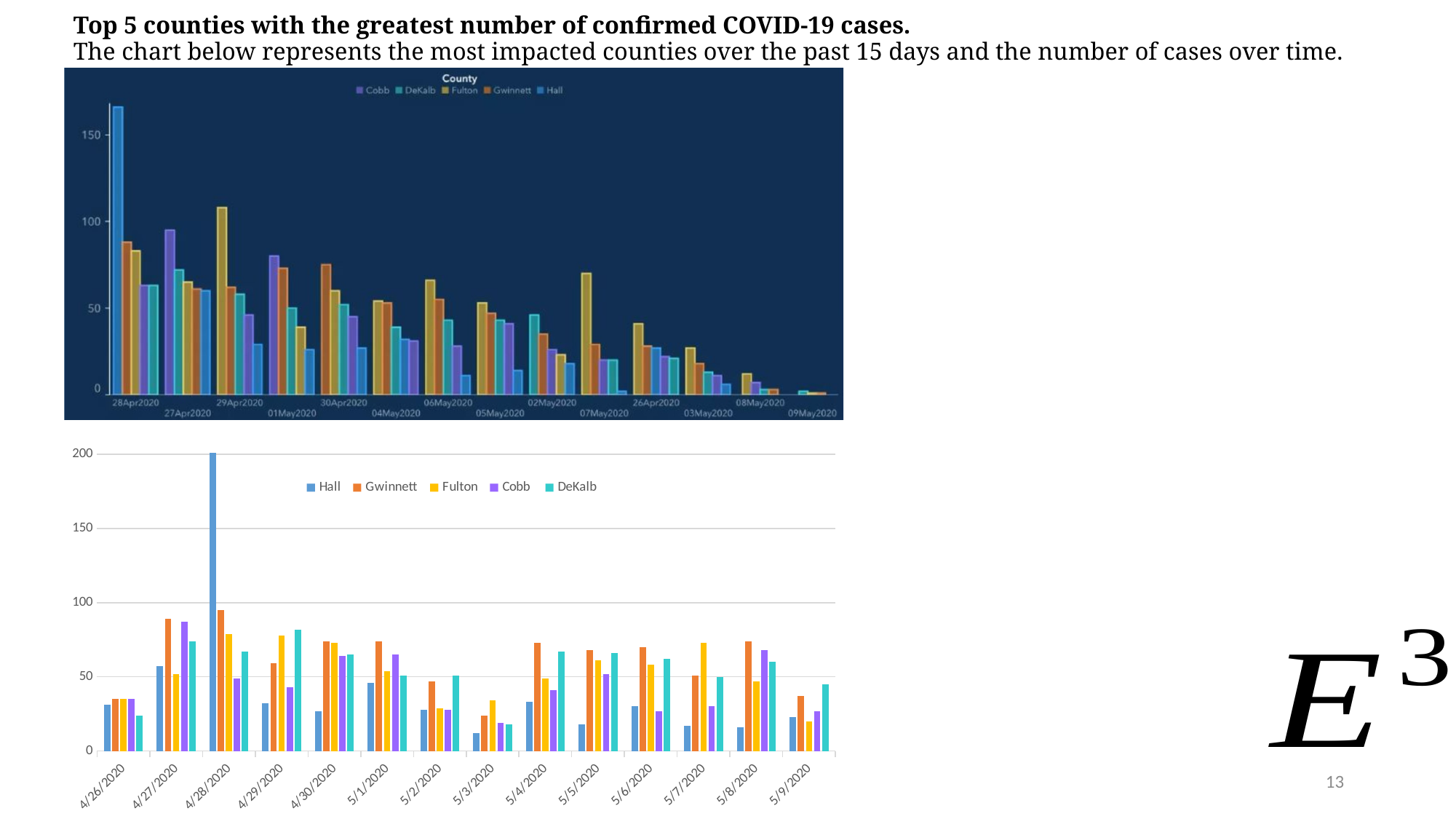
In the top chart, is the value for Hall on 28Apr2020 greater or less than 150? greater In the bottom chart, is the value for DeKalb on 4/26/2020 greater or less than 50? less In the bottom chart, is the value for Hall on 4/28/2020 greater or less than 150? greater What kind of chart is the bottom chart on the slide? bar chart In the bottom chart, which county has the tallest bar on 4/28/2020? Hall In the top chart, how many counties does the legend list? 5 What is the title of the legend in the top chart? County In the bottom chart, how many dates are shown on the x axis? 14 In the bottom chart, how many series does the legend list? 5 In the bottom chart, which is larger on 5/7/2020, Fulton or Cobb? Fulton